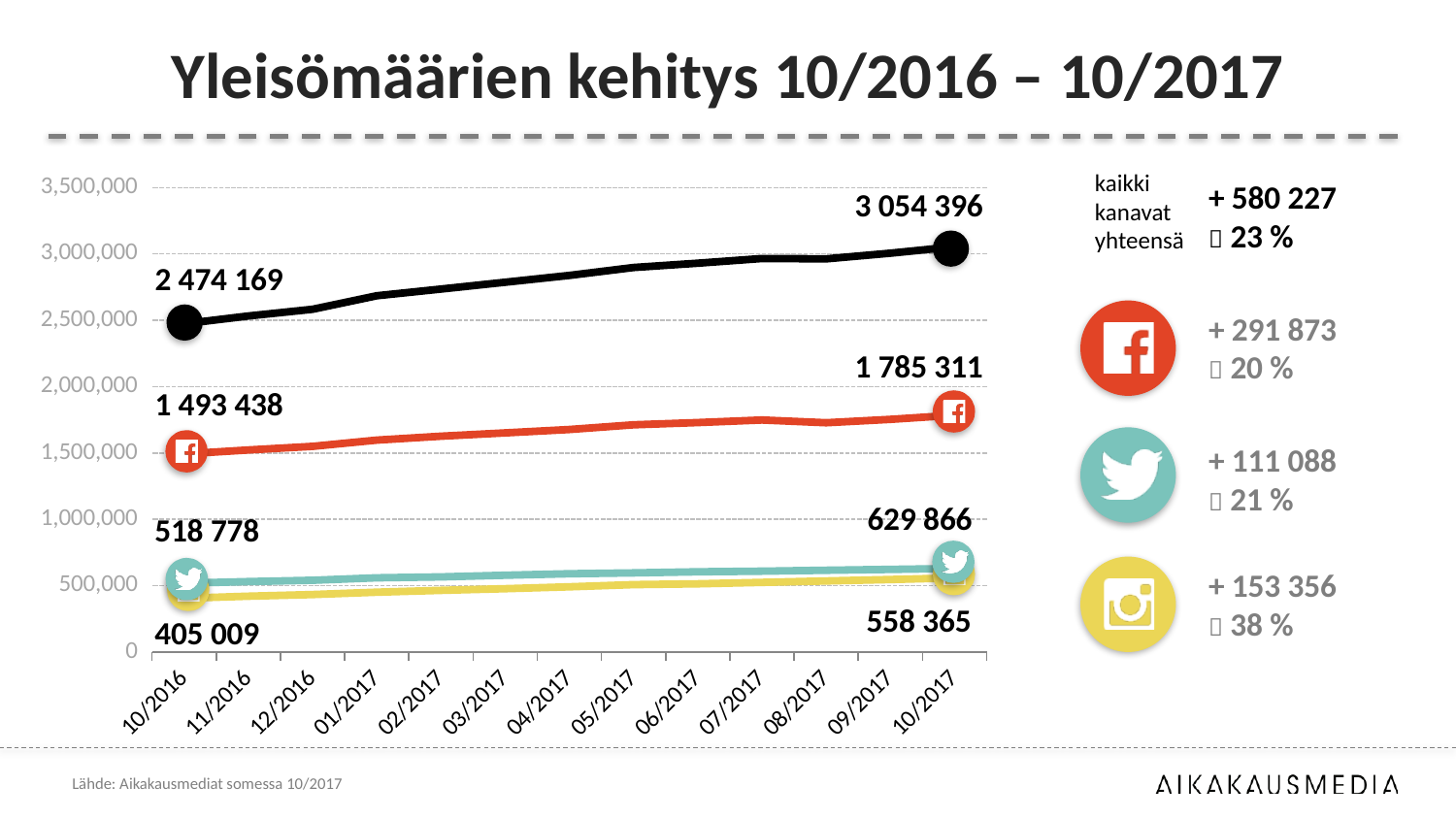
What kind of chart is shown on the slide? line chart At 10/2017, which is larger: the Twitter (teal) value or the Instagram (yellow) value? Twitter (629 866) How many months are shown on the x axis? 13 Is the value of the Facebook (red) line at 04/2017 greater or less than 1,500,000? greater By how much did the Instagram (yellow) line increase from 10/2016 to 10/2017? 153 356 What value is labelled at 10/2016 on the black line (kaikki kanavat yhteensä)? 2 474 169 What value is labelled at 10/2016 on the Twitter (teal) line? 518 778 What value is labelled at 10/2017 on the black line (kaikki kanavat yhteensä)? 3 054 396 By how much did the Facebook (red) line increase from 10/2016 to 10/2017? 291 873 Which line has the lowest value at 10/2016? Instagram (yellow), 405 009 What value is labelled at 10/2017 on the Facebook (red) line? 1 785 311 What value is labelled at 10/2016 on the Instagram (yellow) line? 405 009